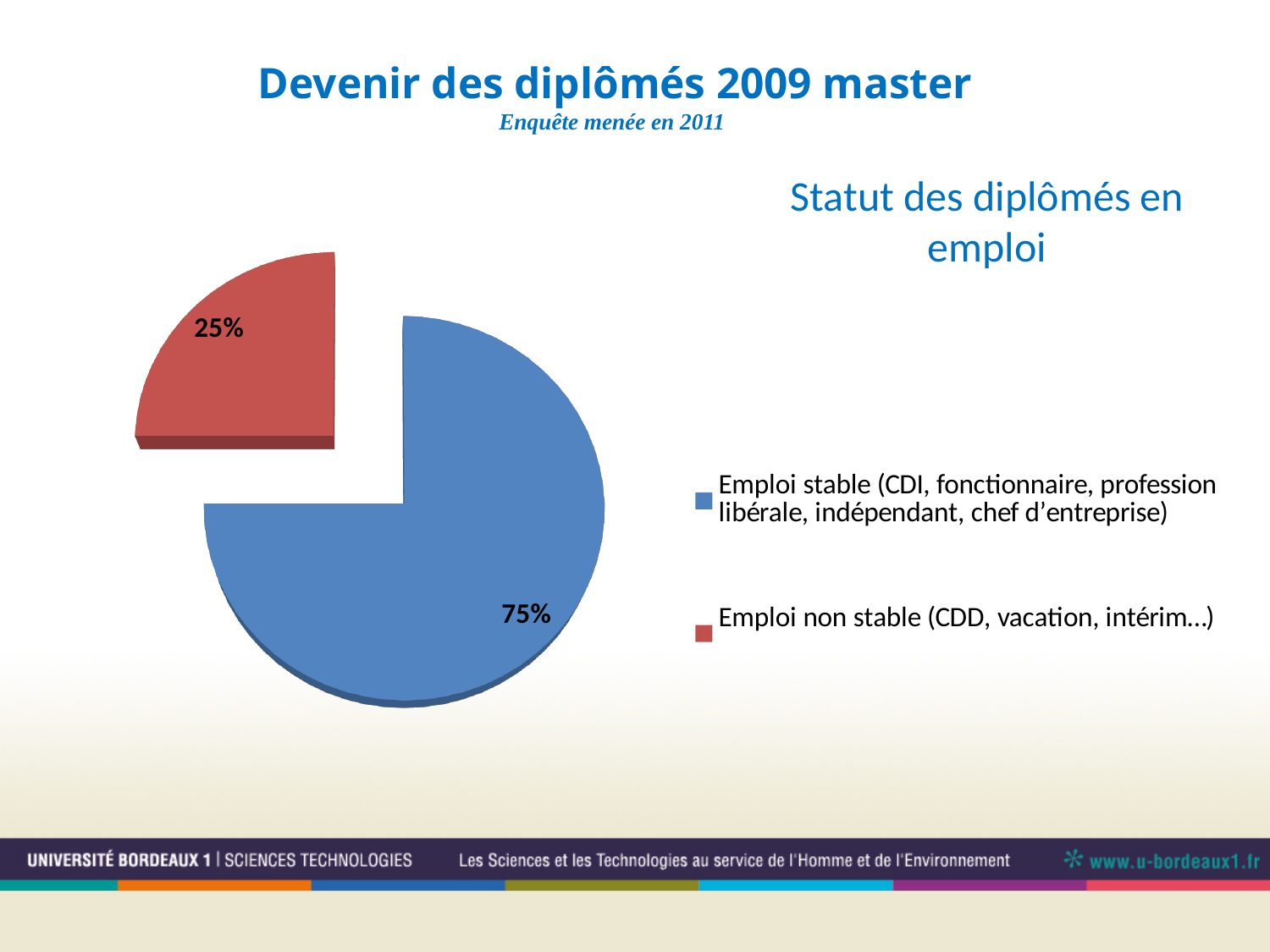
What kind of chart is shown on the slide? pie chart How many slices does the pie chart have? 2 What is the difference in percentage points between the 'Emploi stable' slice and the 'Emploi non stable' slice? 50 What is the chart's title? Statut des diplômés en emploi Which category has the smallest slice of the pie? Emploi non stable (CDD, vacation, intérim…) Which category has the largest slice of the pie? Emploi stable (CDI, fonctionnaire, profession libérale, indépendant, chef d'entreprise) How many entries does the legend list? 2 What colour is the 'Emploi non stable (CDD, vacation, intérim…)' slice? red What share of the pie is 'Emploi stable (CDI, fonctionnaire, profession libérale, indépendant, chef d'entreprise)'? 75% What share of the pie is 'Emploi non stable (CDD, vacation, intérim…)'? 25% Which is larger: the 'Emploi stable' slice or the 'Emploi non stable' slice? Emploi stable